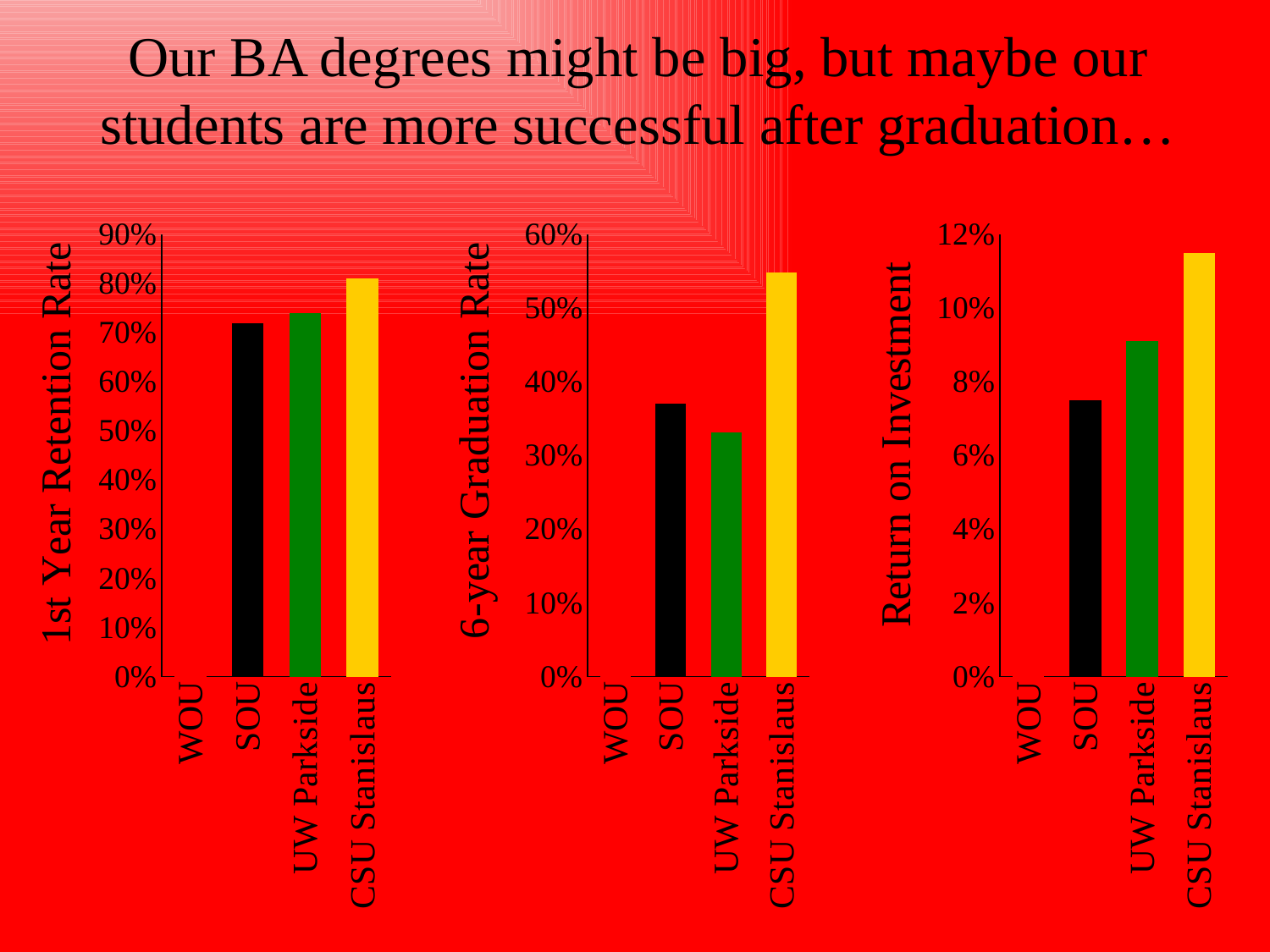
What kind of chart is the 6-year Graduation Rate chart? Bar chart In the 6-year Graduation Rate chart, which is larger, the value for SOU or the value for UW Parkside? SOU In the Return on Investment chart, which is larger, the value for UW Parkside or the value for SOU? UW Parkside In the 1st Year Retention Rate chart, is the value for SOU greater or less than 60%? greater In the Return on Investment chart, is the value for SOU greater or less than 8%? less In the 1st Year Retention Rate chart, is the value for CSU Stanislaus greater or less than 70%? greater How many institutions are listed on the x axis of the Return on Investment chart? 4 In the 6-year Graduation Rate chart, which institution has the highest bar? CSU Stanislaus In the Return on Investment chart, which institution has the highest bar? CSU Stanislaus In the 1st Year Retention Rate chart, which labelled institution has the highest bar? CSU Stanislaus